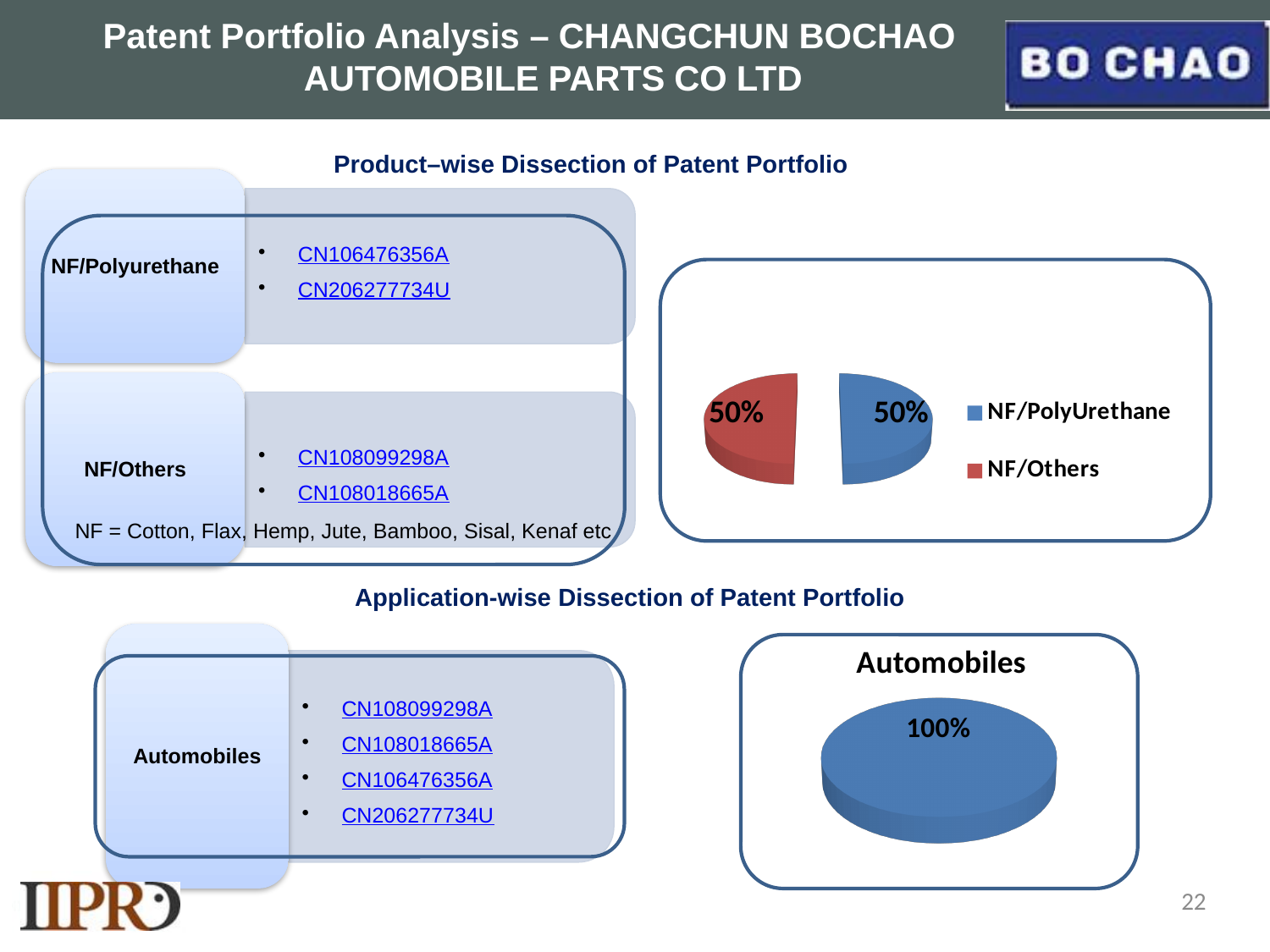
What kind of chart is the Automobiles chart on the lower right of the slide? Pie chart In the product-wise pie chart on the upper right, which colour represents NF/Others? Red How many slices does the Automobiles pie chart on the lower right have? 1 In the product-wise pie chart on the upper right, what share is shown for NF/Others? 50% How many slices does the product-wise pie chart on the upper right have? 2 In the product-wise pie chart on the upper right, what share is shown for NF/PolyUrethane? 50% In the product-wise pie chart on the upper right, what is the difference between the NF/PolyUrethane share and the NF/Others share? 0% What kind of chart is the product-wise chart on the upper right of the slide? Pie chart In the Automobiles pie chart on the lower right, what share is shown for Automobiles? 100% What is the title of the pie chart on the lower right of the slide? Automobiles In the product-wise pie chart on the upper right, which colour represents NF/PolyUrethane? Blue How many entries does the legend of the product-wise pie chart on the upper right list? 2